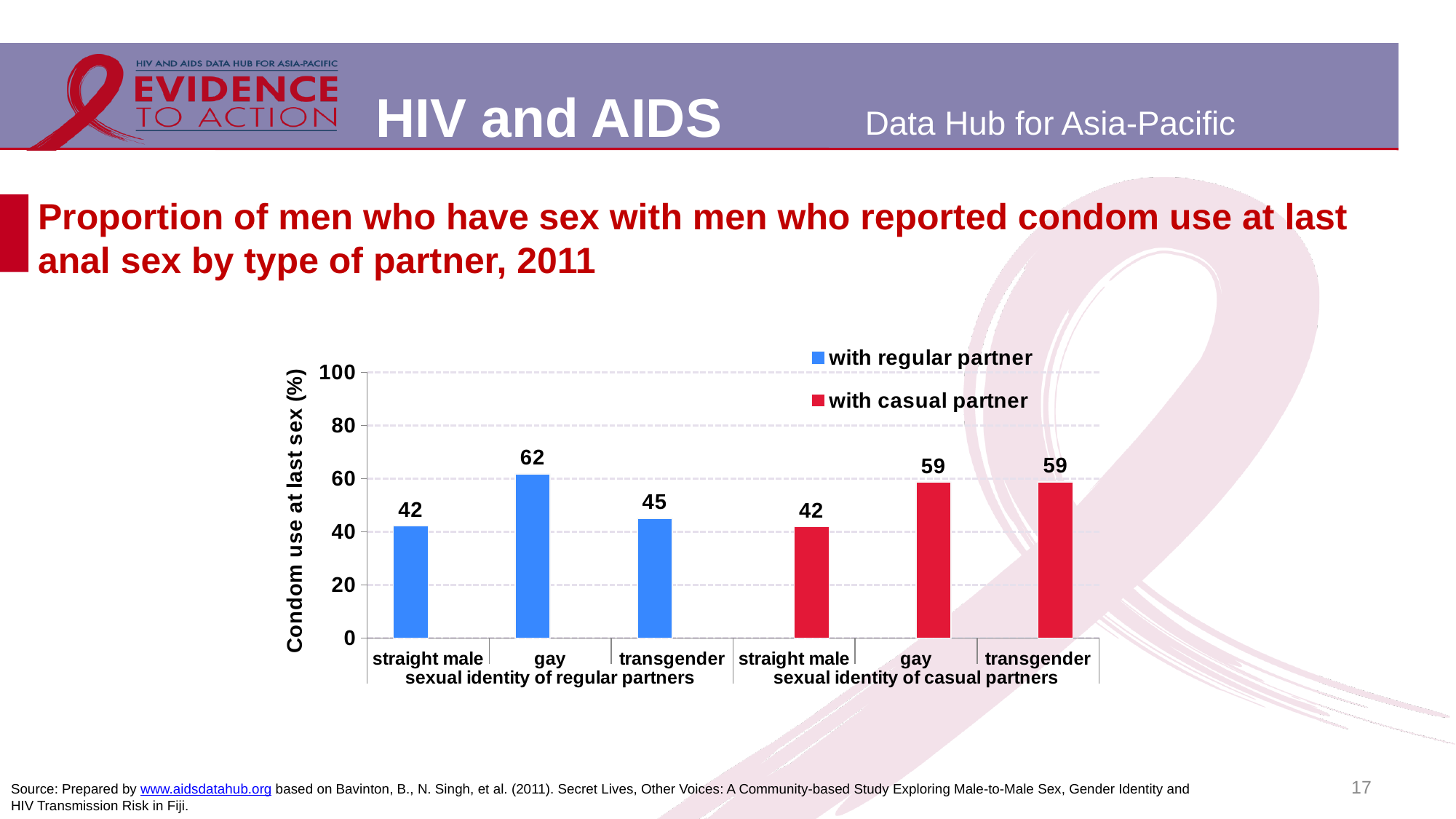
Is the value for gay regular partners greater or less than 60? greater What is the condom use value for gay regular partners? 62 Which is larger: the value for transgender regular partners or transgender casual partners? transgender casual partners How many series does the legend list? 2 Which category has the highest condom use value? gay (regular partners) What is the difference between the values for gay casual partners and straight male casual partners? 17 How many bars are plotted in the chart? 6 What is the condom use value for straight male regular partners? 42 What is the label of the y axis? Condom use at last sex (%) What kind of chart is shown on the slide? bar chart What is the difference between the values for gay regular partners and transgender regular partners? 17 What is the condom use value for transgender casual partners? 59